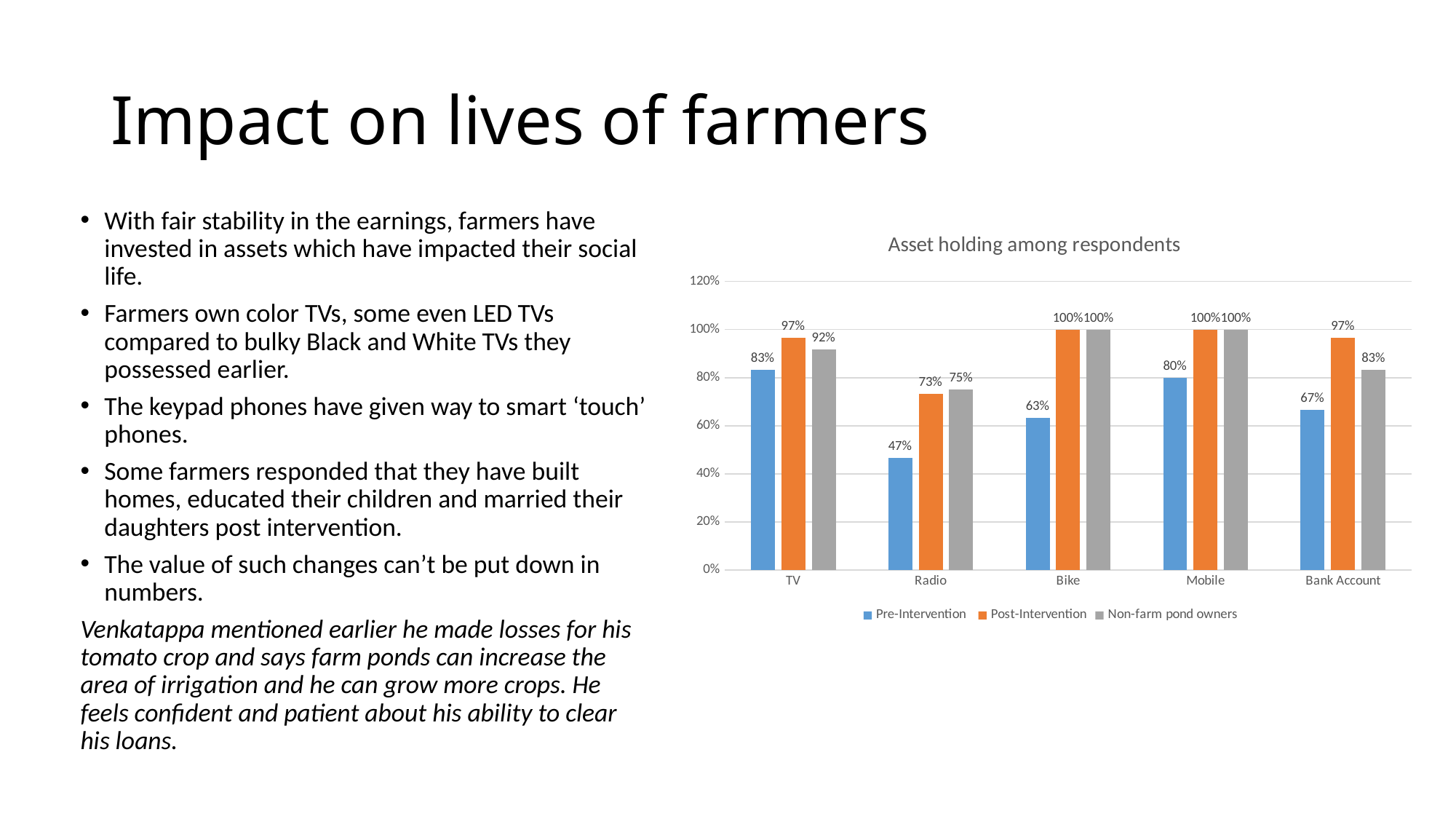
Which category has the lowest Pre-Intervention value? Radio Which category has the lowest Post-Intervention value? Radio What is the difference between the Post-Intervention and Pre-Intervention values for Bike? 37% What is the Pre-Intervention value for Radio? 47% Which is larger for Radio: the Post-Intervention value or the Non-farm pond owners value? Non-farm pond owners What is the Non-farm pond owners value for TV? 92% What is the title of the chart? Asset holding among respondents How many categories are shown on the x axis? 5 What kind of chart is shown on the slide? Bar chart What is the difference between the Post-Intervention and Pre-Intervention values for Bank Account? 30% What is the Post-Intervention value for Bank Account? 97% How many series does the legend list? 3